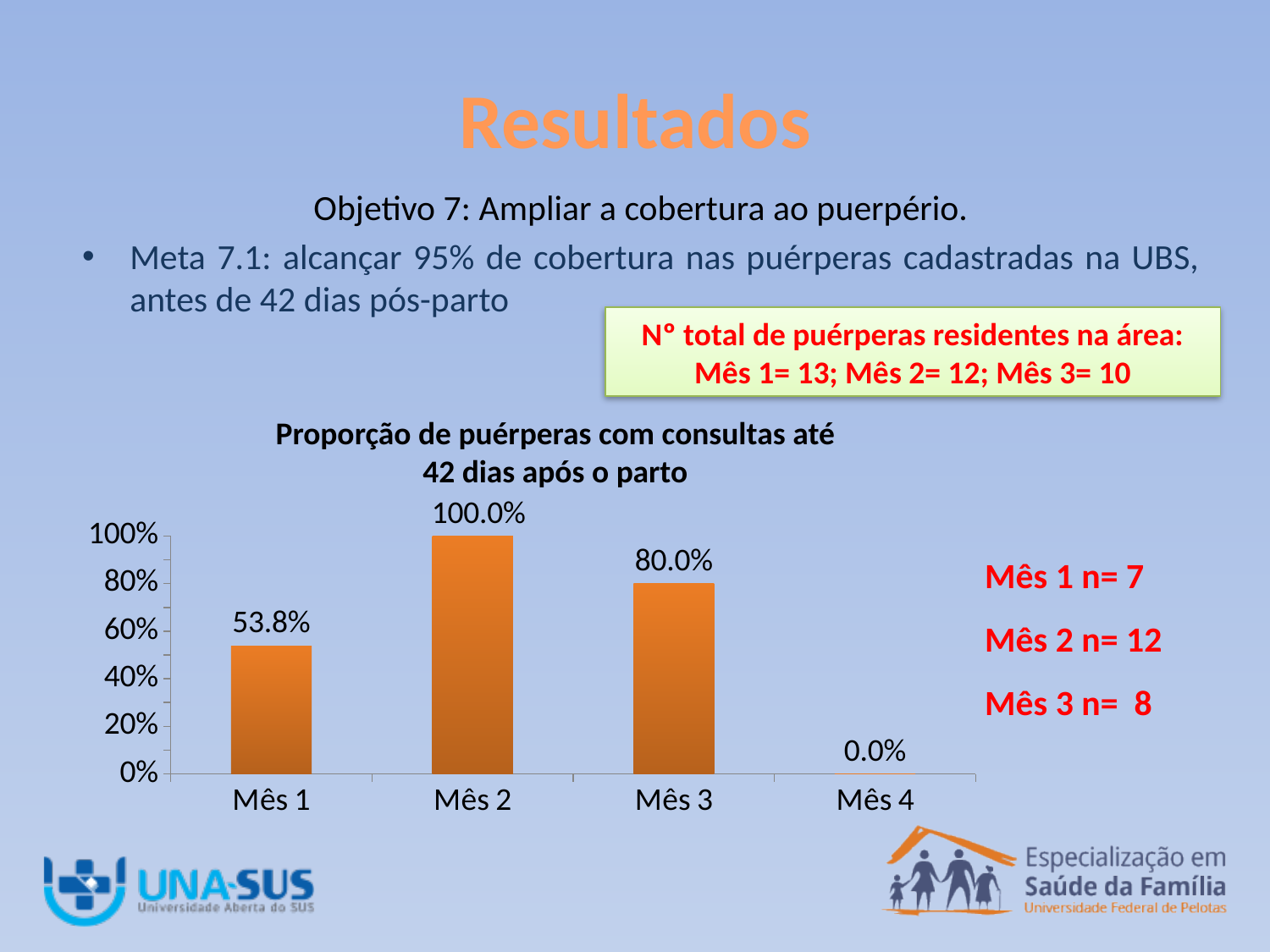
Which is larger, the value for Mês 1 or the value for Mês 3? Mês 3 What is the difference between the values for Mês 2 and Mês 3? 20.0% What is the title of the chart? Proporção de puérperas com consultas até 42 dias após o parto What is the value for Mês 4? 0.0% Which month has the highest value? Mês 2 What is the value for Mês 2? 100.0% What is the value for Mês 3? 80.0% Which month has the lowest value? Mês 4 What kind of chart is shown on the slide? bar chart How many months are shown on the x axis? 4 Is the value for Mês 1 greater or less than 60%? less What is the value for Mês 1? 53.8%